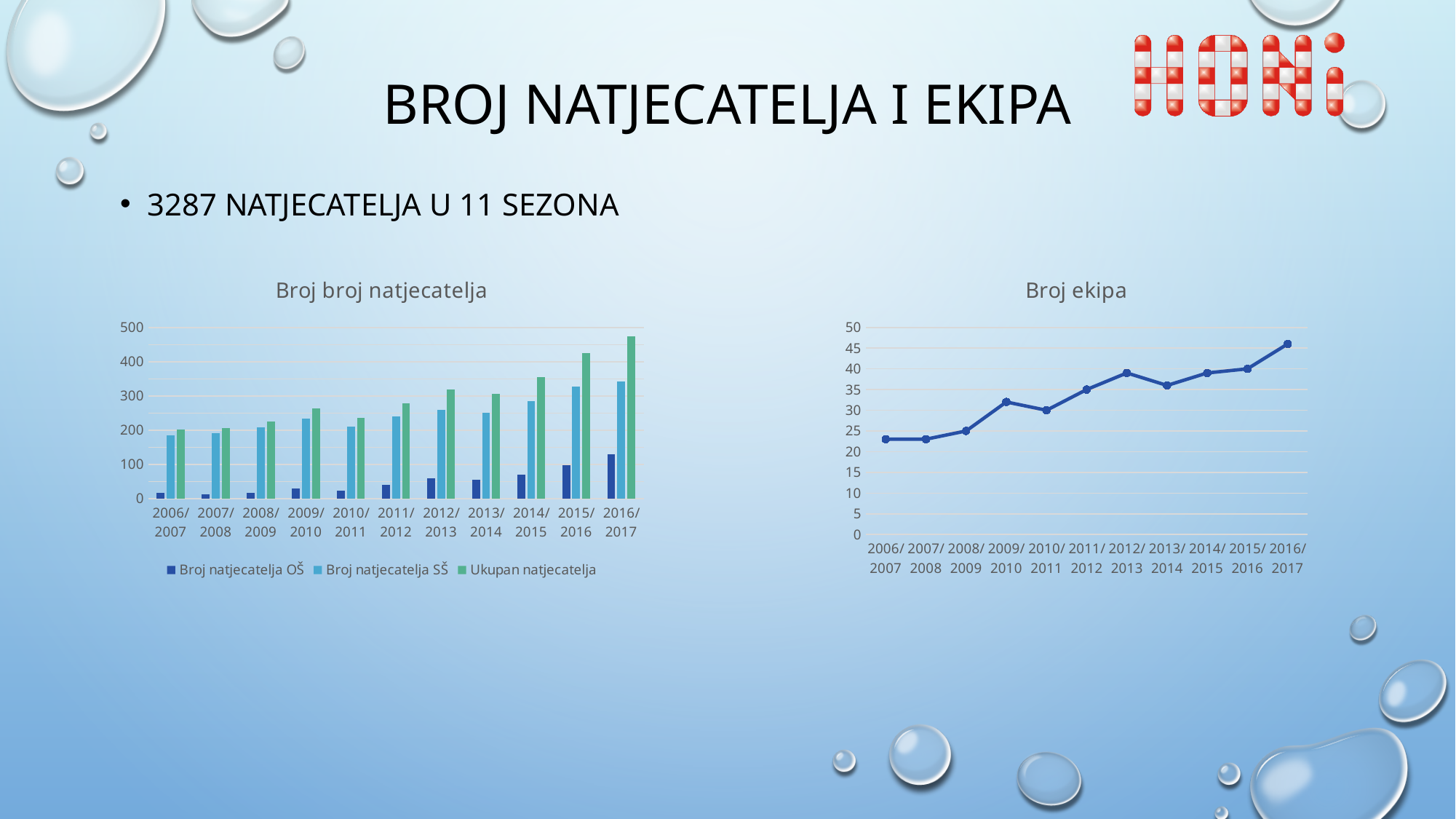
What type of chart is the right chart titled "Broj ekipa"? line chart How many series does the legend of the "Broj broj natjecatelja" chart list? 3 What type of chart is the left chart titled "Broj broj natjecatelja"? bar chart In the "Broj broj natjecatelja" chart, is the value for Broj natjecatelja SŠ in 2006/2007 greater or less than 200? less In the "Broj broj natjecatelja" chart, which season has the highest value for Ukupan natjecatelja? 2016/2017 In the "Broj broj natjecatelja" chart, which is larger for Ukupan natjecatelja: 2013/2014 or 2014/2015? 2014/2015 In the "Broj ekipa" chart, do the values generally rise or fall from 2006/2007 to 2016/2017? rise In the "Broj ekipa" chart, which season has the highest value? 2016/2017 In the "Broj broj natjecatelja" chart, is the value for Ukupan natjecatelja in 2016/2017 greater or less than 400? greater How many seasons are shown on the x axis of the "Broj ekipa" chart? 11 In the "Broj broj natjecatelja" chart, is the value for Broj natjecatelja OŠ in 2016/2017 greater or less than 100? greater